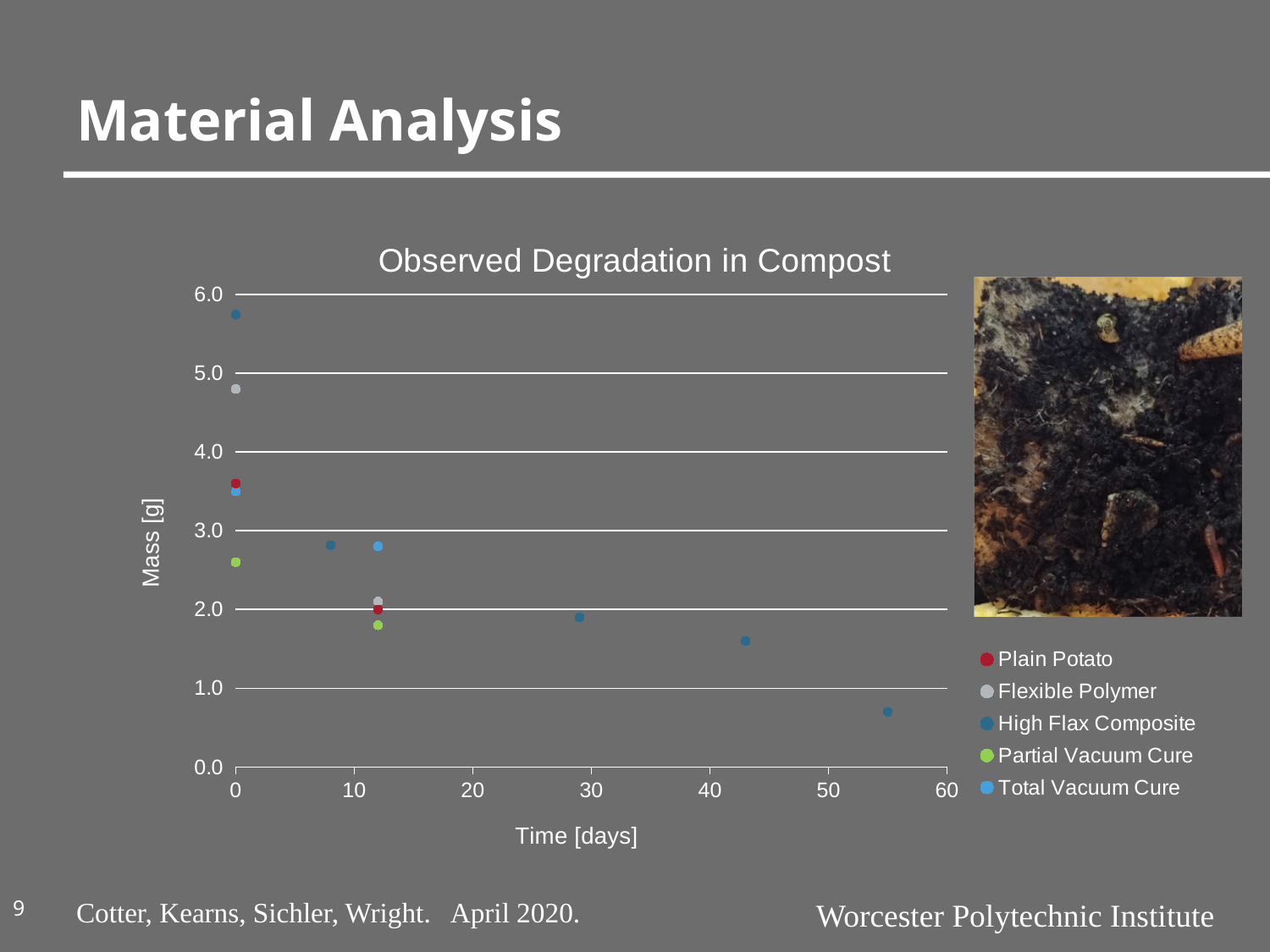
Which series has the highest mass at day 0? High Flax Composite What is the title of the chart? Observed Degradation in Compost Is the mass of Flexible Polymer at day 0 greater or less than 5.0? less Do the plotted mass values rise or fall as time increases? fall Is the mass of Partial Vacuum Cure at day 0 greater or less than 3.0? less Is the last plotted mass of High Flax Composite (around day 55) greater or less than 1.0? less How many series does the legend of the chart list? 5 What kind of chart is shown on the slide? scatter chart Which series has the lowest mass at day 0? Partial Vacuum Cure What is the label of the y axis of the chart? Mass [g] Which series has the most plotted points on the chart? High Flax Composite